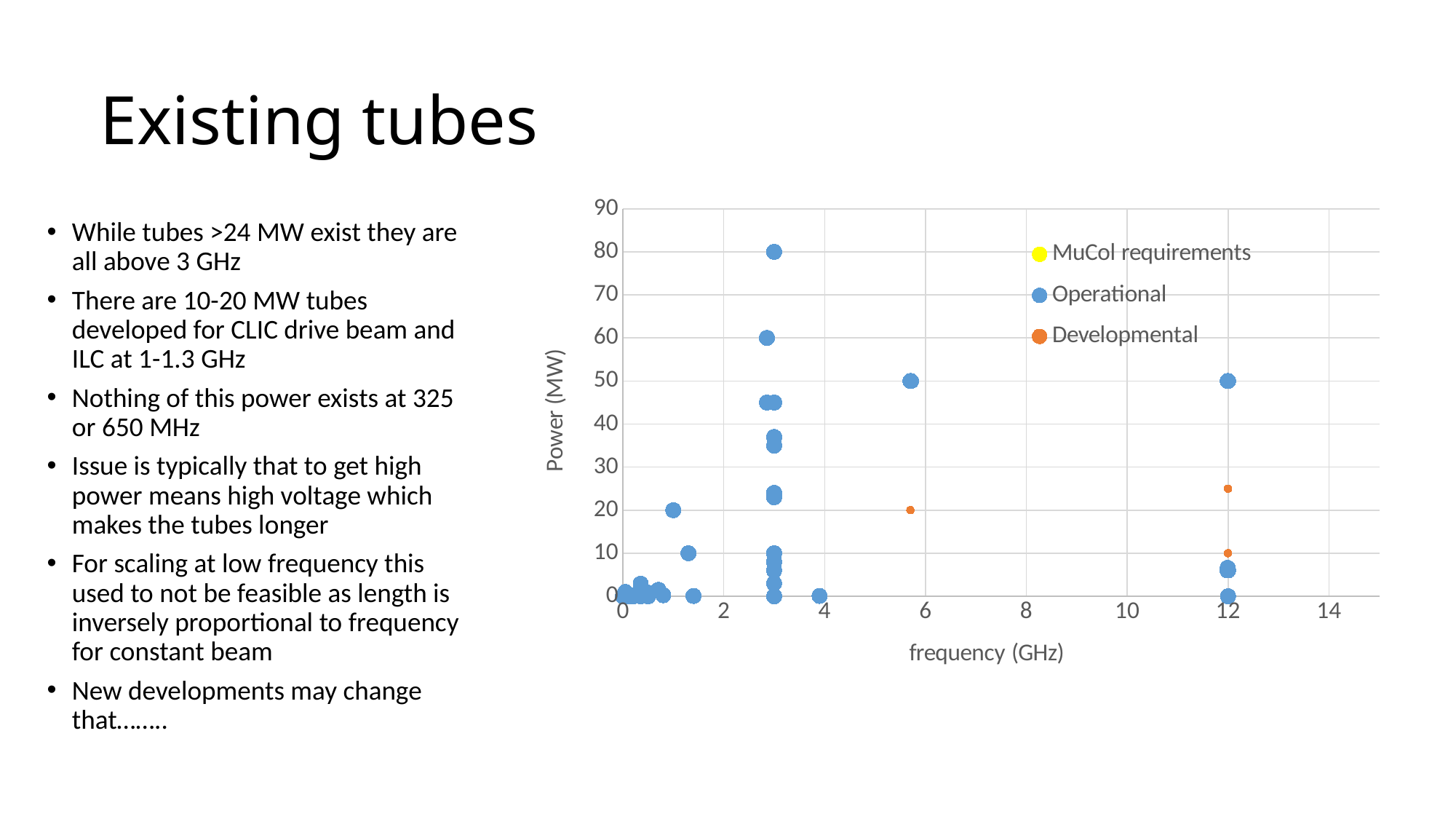
What are the three series named in the chart legend? MuCol requirements, Operational, Developmental Is the Developmental point near 6 GHz greater or less than 30 MW? less Is the Operational point at about 1 GHz greater or less than 30 MW? less What is the label of the chart's x axis? frequency (GHz) What kind of chart is shown on the slide? scatter chart Is the Developmental point near 12 GHz with the higher power greater or less than 20 MW? greater Which has the higher maximum power: the Operational points near 3 GHz or the Operational points near 12 GHz? near 3 GHz How many series does the chart legend list? 3